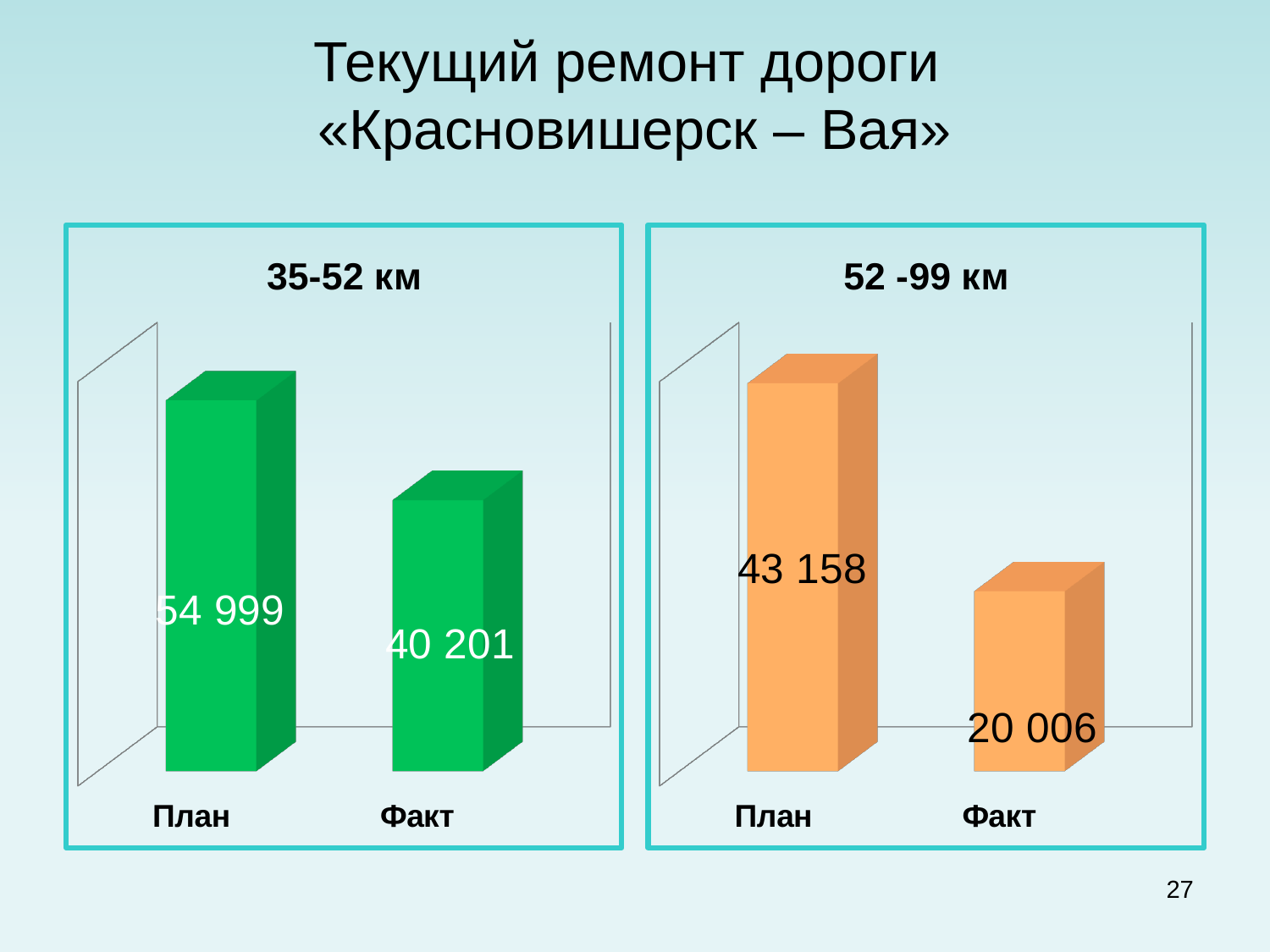
In the "35-52 км" chart, what is the value for Факт? 40 201 In the "35-52 км" chart, which category has the higher value? План In the "35-52 км" chart, what is the value for План? 54 999 In the "52 -99 км" chart, what is the value for Факт? 20 006 In the "52 -99 км" chart, what is the value for План? 43 158 In the "35-52 км" chart, what is the difference between План and Факт? 14 798 What colour are the bars in the "52 -99 км" chart? Orange In the "52 -99 км" chart, what is the difference between План and Факт? 23 152 How many categories are shown in the "52 -99 км" chart? 2 What kind of chart is the "35-52 км" chart? Bar chart Which is larger: План in the "35-52 км" chart or План in the "52 -99 км" chart? План in the "35-52 км" chart In the "52 -99 км" chart, which category has the lowest value? Факт